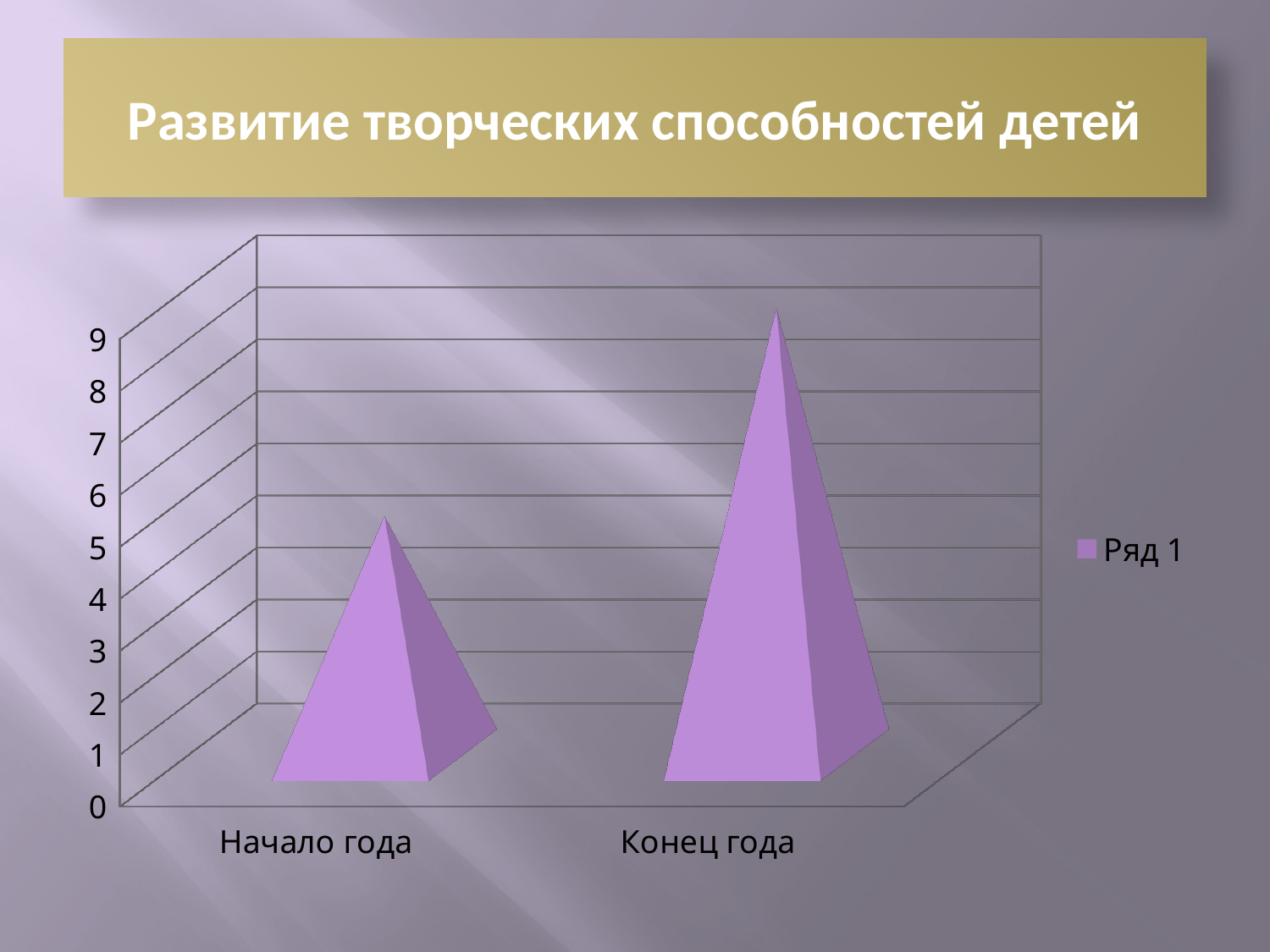
What kind of chart is shown on the slide? bar chart Is the value for Конец года greater or less than 6? greater What is the name of the series shown in the chart legend? Ряд 1 Which category has the lowest value in the chart? Начало года What is the title of the slide containing the chart? Развитие творческих способностей детей Which is larger, the value for Начало года or the value for Конец года? Конец года Which category has the highest value in the chart? Конец года How many series does the chart legend list? 1 Do the values rise or fall from Начало года to Конец года? rise Is the value for Начало года greater or less than 8? less How many categories are shown on the x axis of the chart? 2